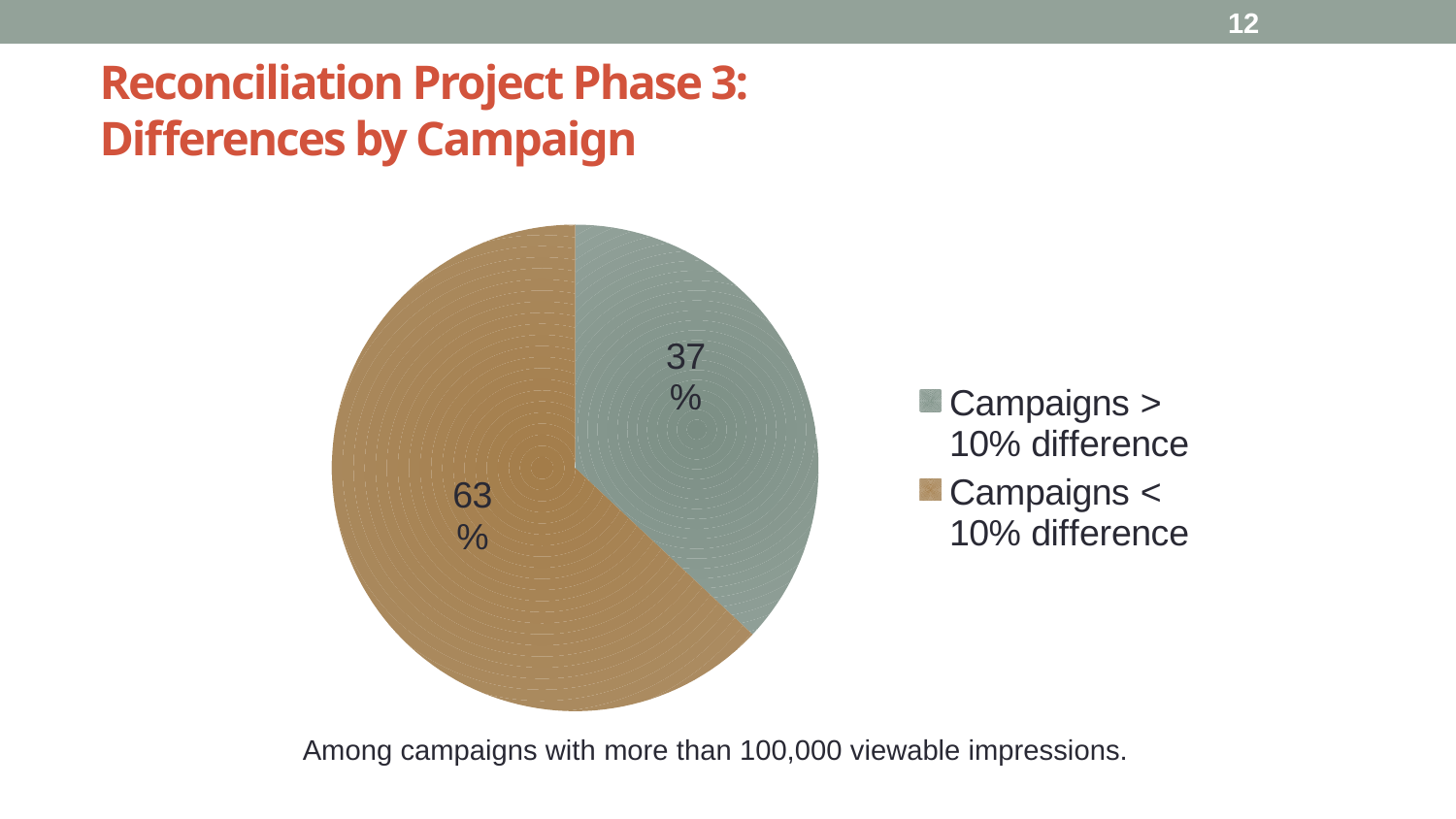
According to the note below the chart, which campaigns are included in the pie? Campaigns with more than 100,000 viewable impressions How many slices does the pie chart have? 2 Which slice is larger: "Campaigns > 10% difference" or "Campaigns < 10% difference"? Campaigns < 10% difference What kind of chart is shown on the slide? Pie chart Which category has the smallest slice of the pie? Campaigns > 10% difference Which legend entry is shown in the brown/tan colour? Campaigns < 10% difference What is the total of the two slice percentages shown on the pie? 100% What is the difference in percentage points between the "Campaigns < 10% difference" slice and the "Campaigns > 10% difference" slice? 26 How many entries does the legend list? 2 What share of the pie is labelled "Campaigns < 10% difference"? 63% What share of the pie is labelled "Campaigns > 10% difference"? 37% Which category has the largest slice of the pie? Campaigns < 10% difference